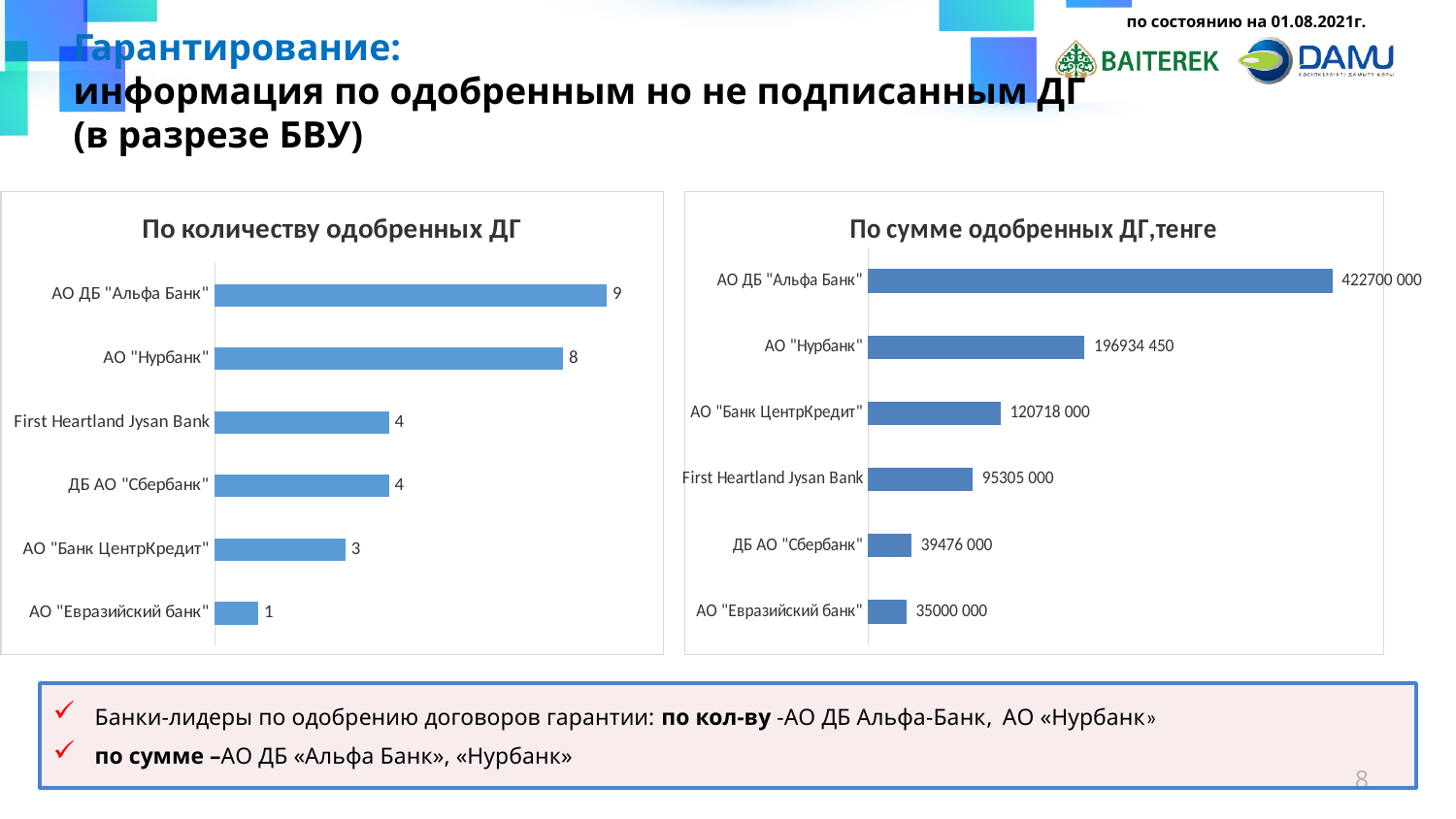
In the chart "По количеству одобренных ДГ", which bank has the lowest value? АО "Евразийский банк" In the chart "По сумме одобренных ДГ,тенге", what is the difference between АО ДБ "Альфа Банк" and АО "Нурбанк"? 225765 550 In the chart "По количеству одобренных ДГ", what is the value for АО "Нурбанк"? 8 In the chart "По количеству одобренных ДГ", what is the difference between АО ДБ "Альфа Банк" and АО "Банк ЦентрКредит"? 6 What type of chart is "По сумме одобренных ДГ,тенге"? Bar chart In the chart "По сумме одобренных ДГ,тенге", which is larger: ДБ АО "Сбербанк" or АО "Евразийский банк"? ДБ АО "Сбербанк" In the chart "По сумме одобренных ДГ,тенге", which bank has the lowest value? АО "Евразийский банк" What is the title of the chart on the left side of the slide? По количеству одобренных ДГ In the chart "По сумме одобренных ДГ,тенге", what is the value for First Heartland Jysan Bank? 95305 000 In the chart "По количеству одобренных ДГ", which bank has the highest value? АО ДБ "Альфа Банк" In the chart "По сумме одобренных ДГ,тенге", what is the value for АО "Банк ЦентрКредит"? 120718 000 In the chart "По количеству одобренных ДГ", how many banks are shown? 6